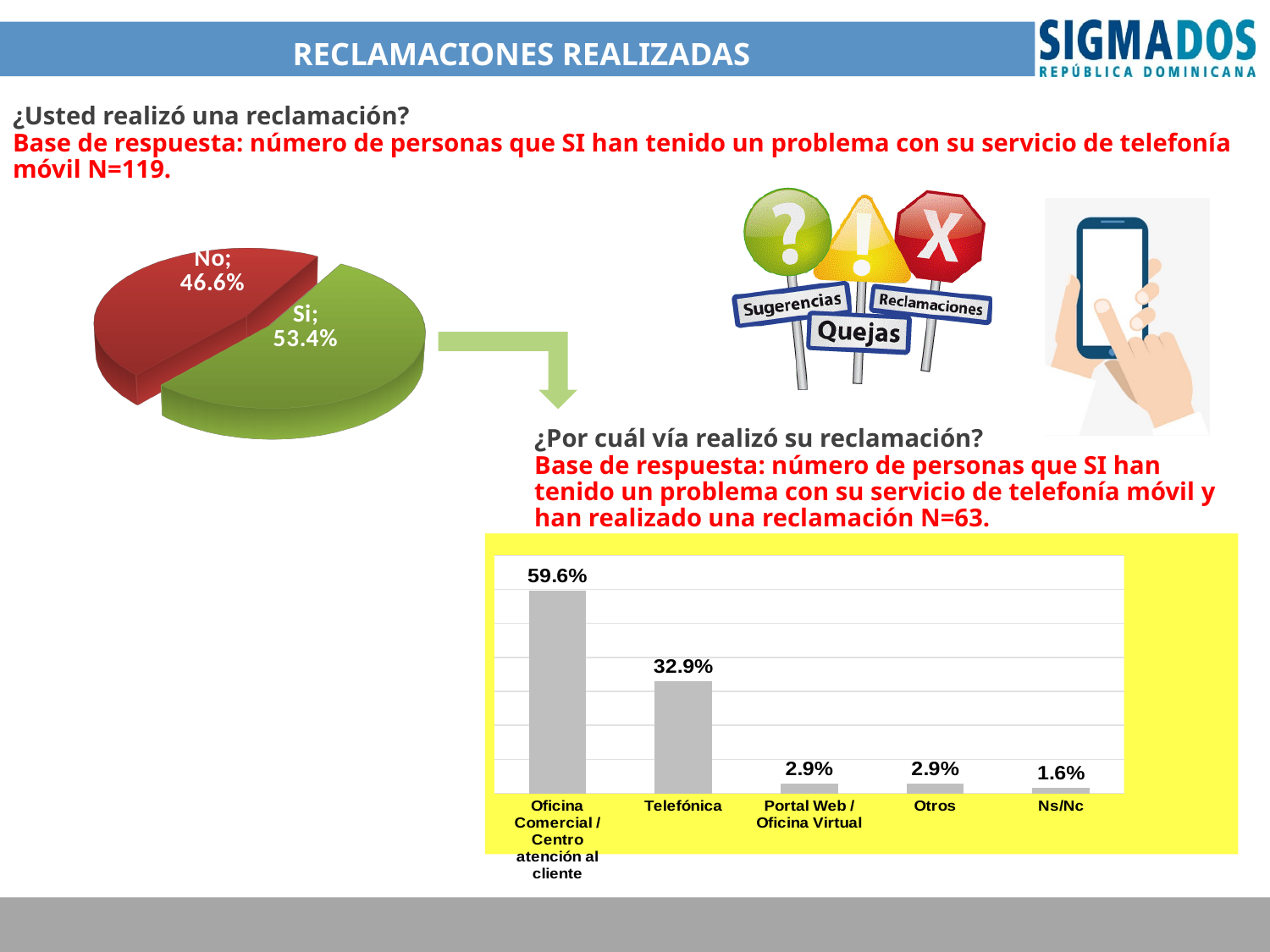
In the bar chart at the bottom right, what is the value for 'Oficina Comercial / Centro atención al cliente'? 59.6% In the pie chart on the left, what percentage of respondents answered 'Si'? 53.4% In the bar chart at the bottom right, which category has the highest value? Oficina Comercial / Centro atención al cliente In the bar chart at the bottom right, how many categories are shown? 5 In the pie chart on the left, what percentage of respondents answered 'No'? 46.6% In the bar chart at the bottom right, which category has the lowest value? Ns/Nc In the pie chart on the left, what is the difference in percentage points between 'Si' and 'No'? 6.8 What kind of chart is the chart on the left of the slide? Pie chart In the pie chart on the left, which answer has the larger share, 'Si' or 'No'? Si In the bar chart at the bottom right, what is the value for 'Telefónica'? 32.9% In the bar chart at the bottom right, what is the difference between 'Oficina Comercial / Centro atención al cliente' and 'Telefónica'? 26.7 percentage points What kind of chart is the chart at the bottom right of the slide? Bar chart